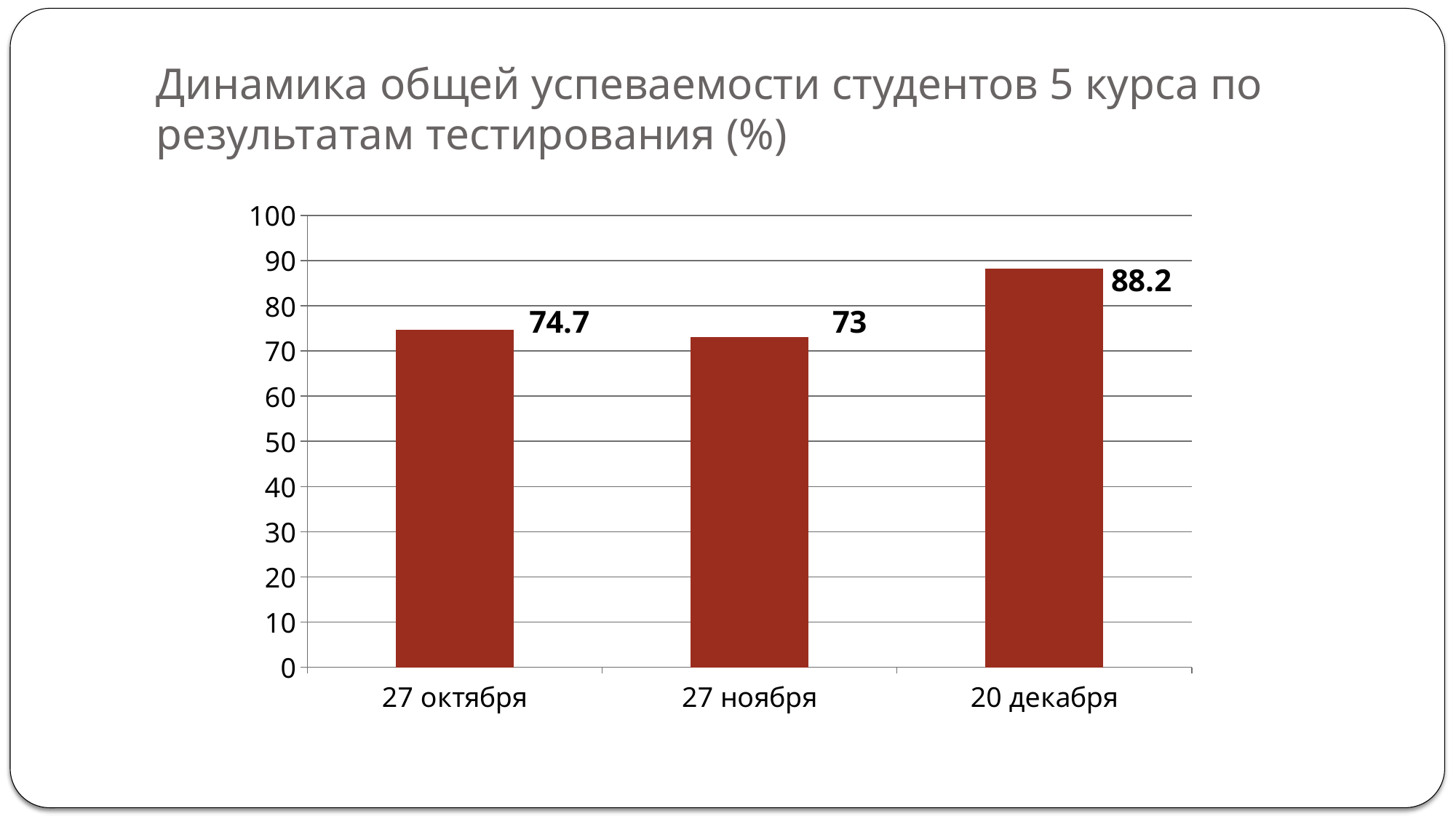
What is the value for 27 октября? 74.7 Which date has the highest value? 20 декабря How many dates are shown on the x axis? 3 Is the value for 20 декабря greater or less than 80? greater What kind of chart is shown on the slide? bar chart What is the value for 20 декабря? 88.2 Which is larger, the value for 27 октября or the value for 20 декабря? 20 декабря Which date has the lowest value? 27 ноября What is the difference between the values for 27 октября and 27 ноября? 1.7 What is the title of the chart? Динамика общей успеваемости студентов 5 курса по результатам тестирования (%) What is the value for 27 ноября? 73 What is the difference between the values for 20 декабря and 27 ноября? 15.2